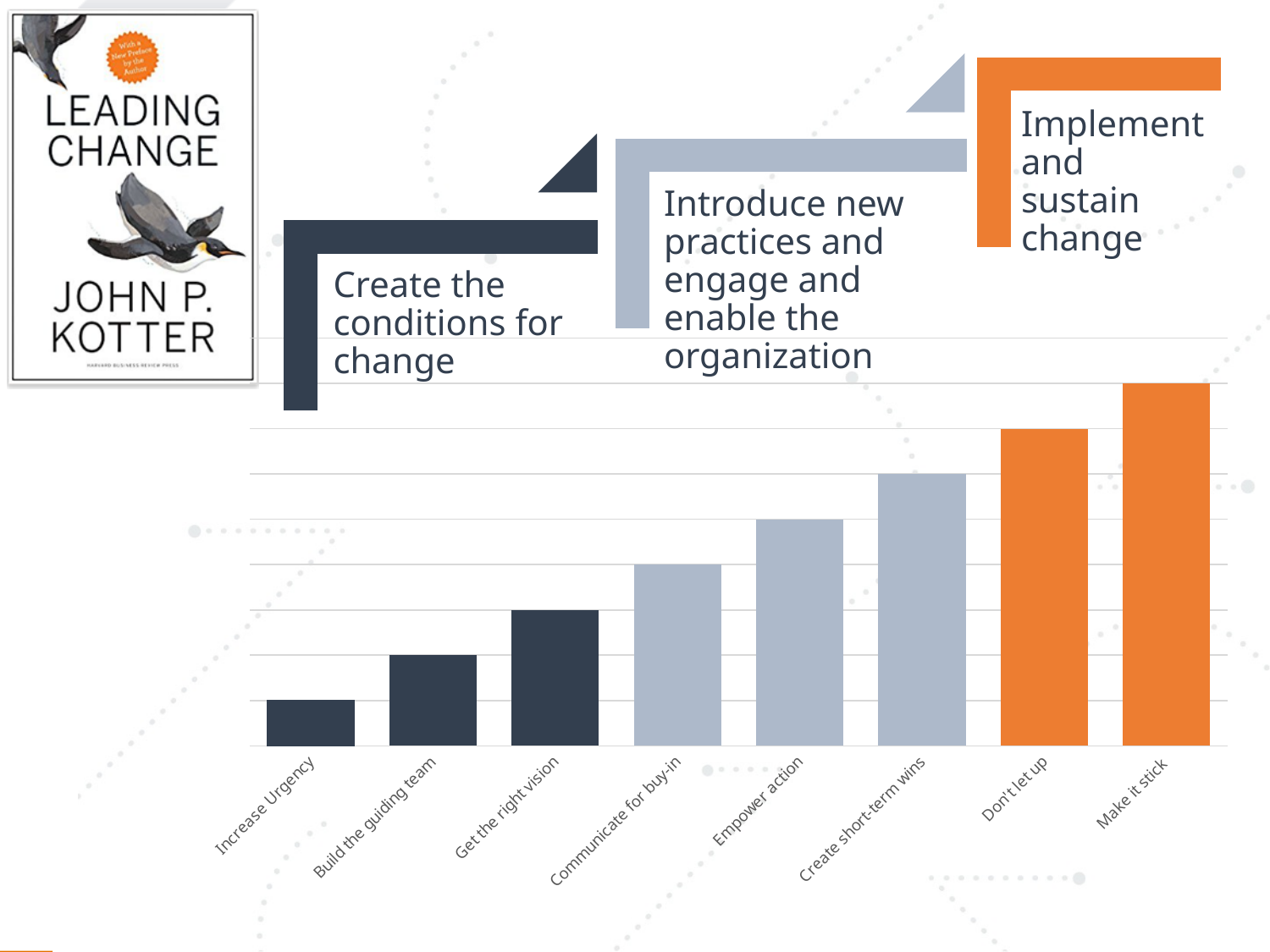
Which category has the tallest bar? Make it stick Which bar is shorter, Build the guiding team or Communicate for buy-in? Build the guiding team How many bars are coloured orange? 2 Which bar is taller, Empower action or Get the right vision? Empower action How many categories (bars) does the chart show? 8 Do the bar heights rise or fall from left to right along the x axis? Rise What is the label of the first bar on the left? Increase Urgency Which category has the shortest bar? Increase Urgency What kind of chart is shown on the slide? Bar chart Which bar is taller, Don't let up or Create short-term wins? Don't let up